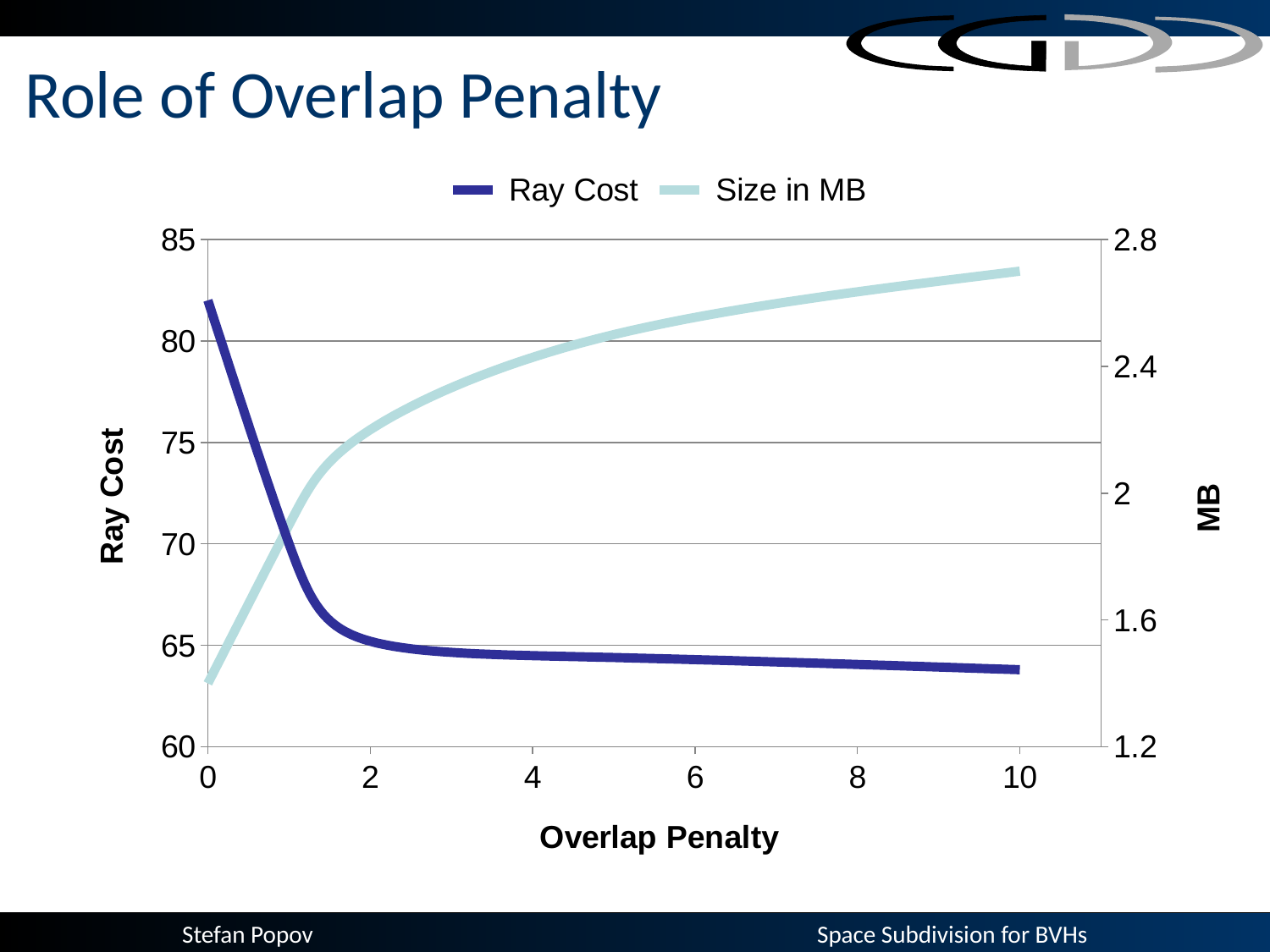
How many series does the legend list? 2 Is the Ray Cost value at Overlap Penalty 4 greater or less than 65? less Is the Size in MB value at Overlap Penalty 0 greater or less than 1.6? less Does the Ray Cost series rise or fall as Overlap Penalty increases? fall Is the Ray Cost value at Overlap Penalty 0 greater or less than 80? greater Does the Size in MB series rise or fall as Overlap Penalty increases? rise What kind of chart is shown on the slide? line chart What is the title of the chart on the slide? Role of Overlap Penalty What is the label of the x axis? Overlap Penalty